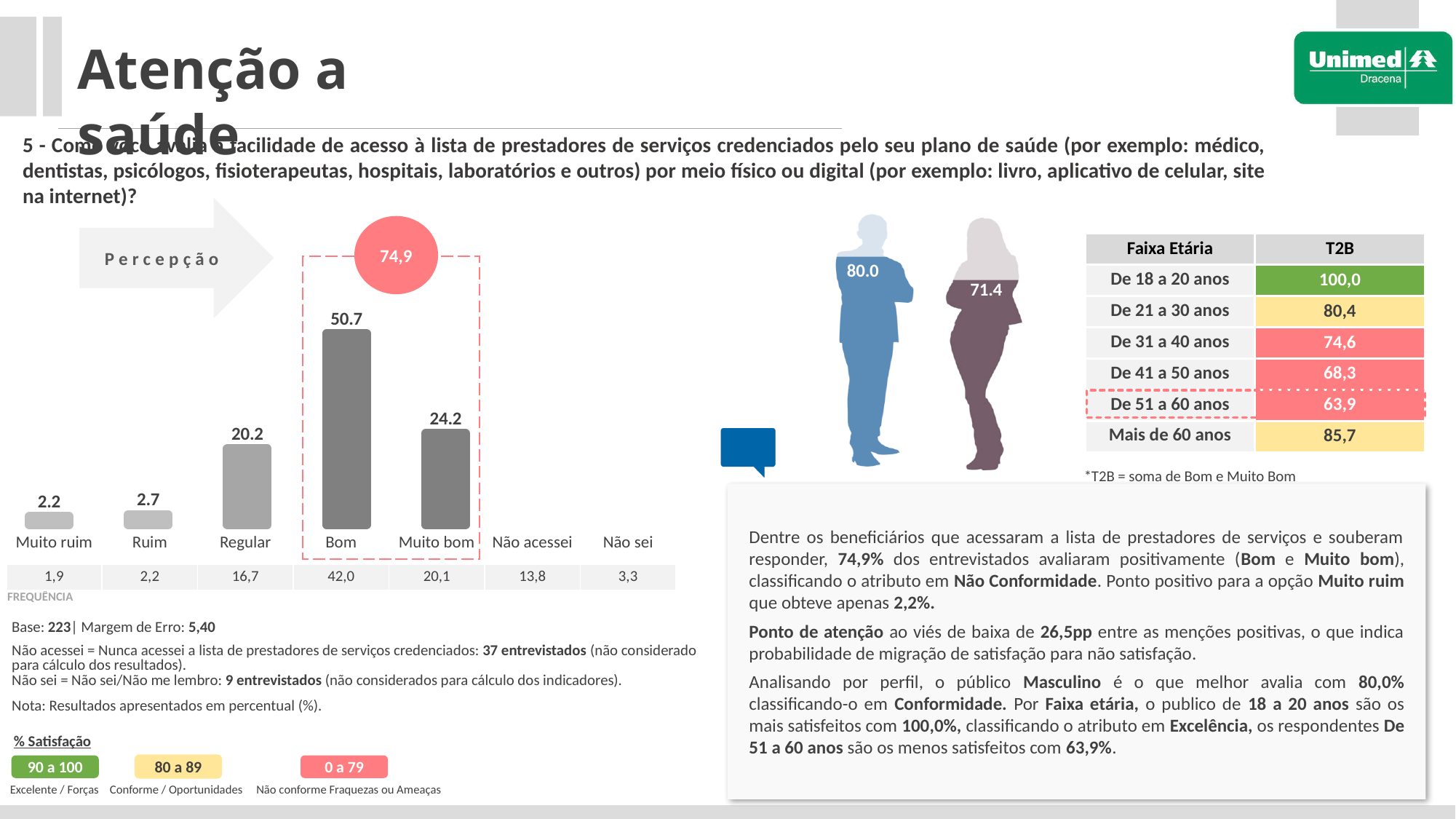
In the bar chart, what is the value for Regular? 20.2 In the bar chart, what is the value for Muito ruim? 2.2 In the bar chart, which category has the lowest value? Muito ruim How many bars are plotted in the bar chart? 5 What kind of chart is shown on the left of the slide? bar chart In the bar chart, what is the combined value of Bom and Muito bom shown in the circle above the highlighted bars? 74,9 In the bar chart, what is the difference between the values for Regular and Ruim? 17.5 In the bar chart, what is the value for Muito bom? 24.2 In the bar chart, which category has the highest value? Bom In the bar chart, what is the difference between the values for Bom and Muito bom? 26.5 In the bar chart, what is the value for Bom? 50.7 In the bar chart, which is larger, the value for Regular or the value for Muito bom? Muito bom